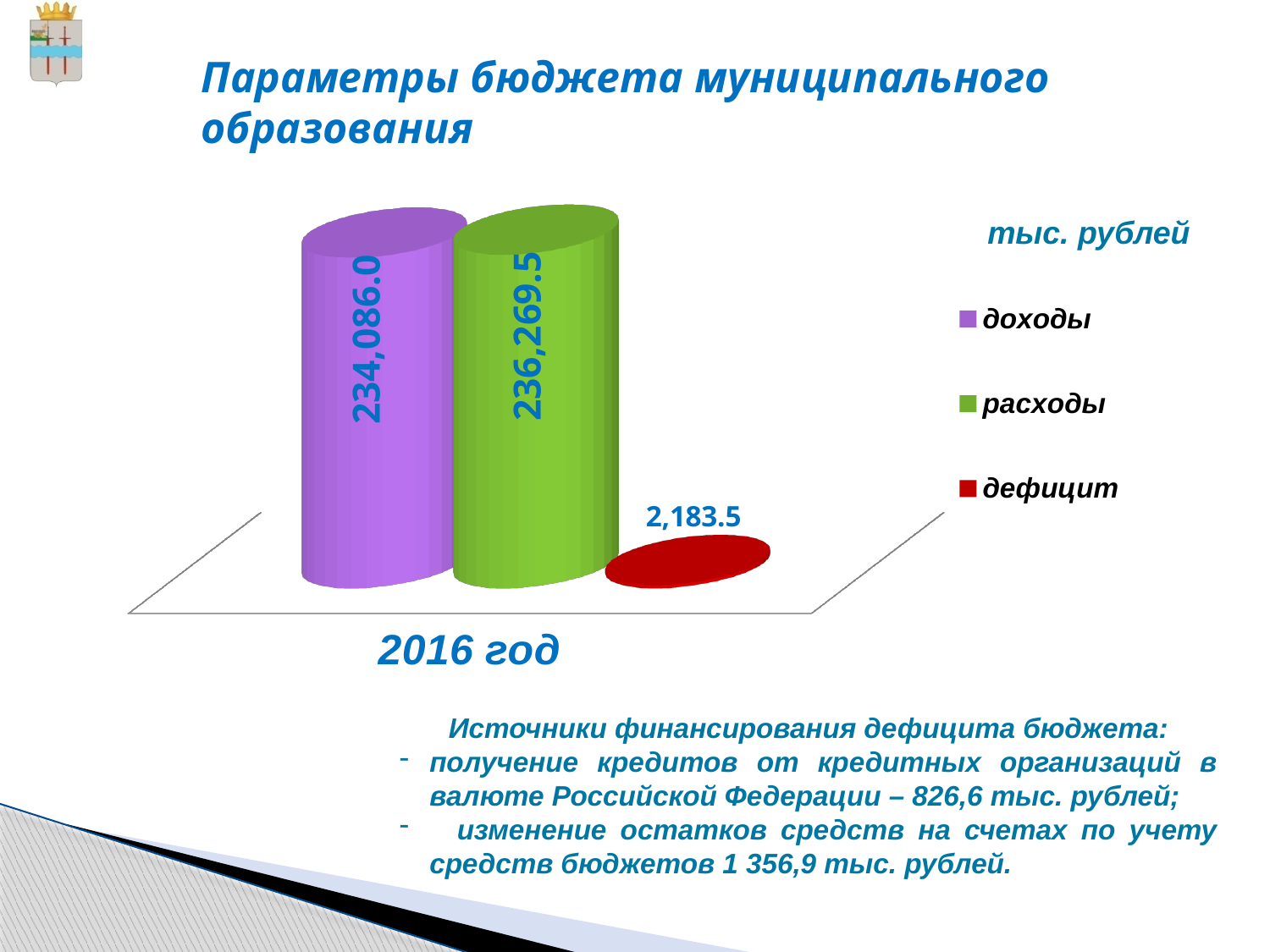
Which is larger, доходы or расходы? расходы What unit is indicated for the chart values? тыс. рублей Which series has the lowest value in the chart? дефицит What is the value for доходы in 2016 год? 234,086.0 What kind of chart is shown on the slide? bar chart How many series does the legend list? 3 How many categories are shown on the x axis? 1 What is the value for дефицит in 2016 год? 2,183.5 Which series has the highest value in the chart? расходы What is the difference between расходы and доходы? 2,183.5 What is the value for расходы in 2016 год? 236,269.5 What colour represents дефицит in the chart? red